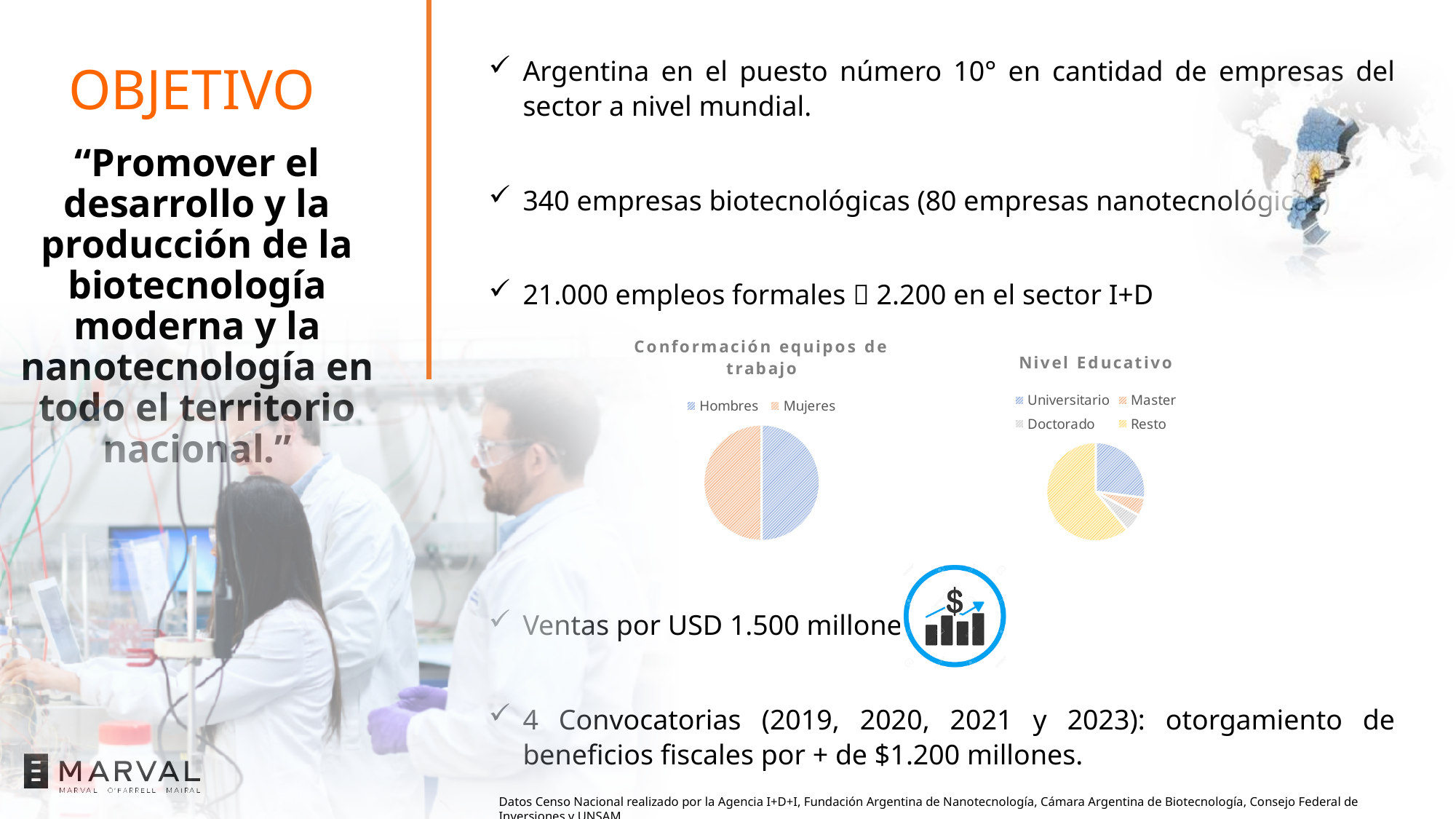
In the "Nivel Educativo" chart, which slice is larger, Resto or Doctorado? Resto In the "Nivel Educativo" chart, which slice is larger, Universitario or Master? Universitario What is the title of the pie chart on the right side of the slide? Nivel Educativo How many slices does the "Conformación equipos de trabajo" pie chart have? 2 In the "Nivel Educativo" chart, which category has the largest slice? Resto In the "Nivel Educativo" chart, which slice is larger, Resto or Universitario? Resto How many entries does the legend of the "Conformación equipos de trabajo" chart list? 2 How many entries does the legend of the "Nivel Educativo" chart list? 4 What kind of chart is the "Nivel Educativo" chart? pie chart How many slices does the "Nivel Educativo" pie chart have? 4 What kind of chart is the "Conformación equipos de trabajo" chart? pie chart What are the two categories shown in the legend of the "Conformación equipos de trabajo" chart? Hombres and Mujeres